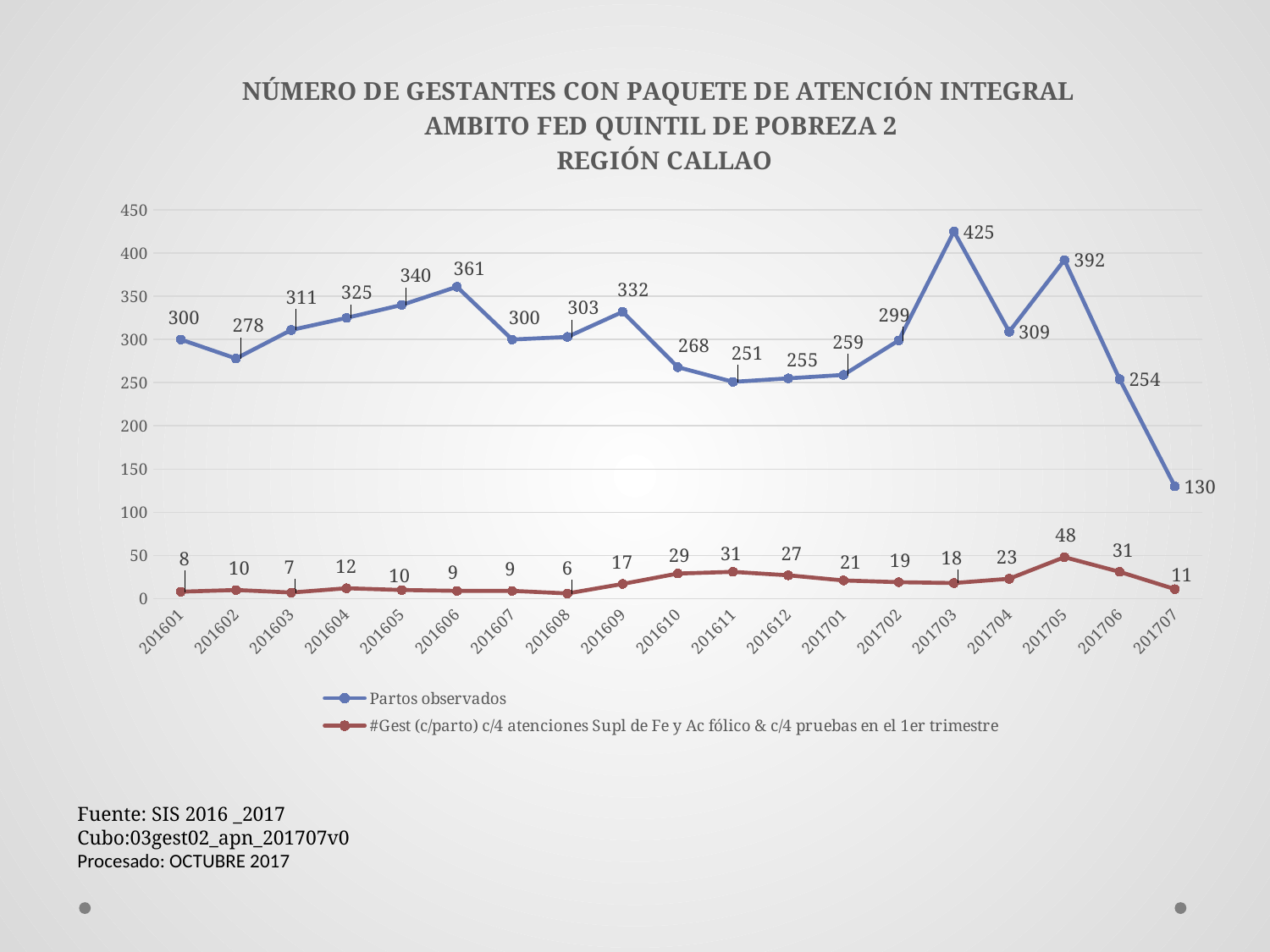
Does the Partos observados series rise or fall from 201705 to 201707? Fall What is the value of Partos observados for 201707? 130 What kind of chart is shown on the slide? Line chart Which period has the lowest value for the #Gest (c/parto) series? 201608 What is the value of the #Gest (c/parto) series for 201705? 48 Is the value of Partos observados for 201705 greater or less than 350? greater What is the value of Partos observados for 201703? 425 Which period has the highest value for Partos observados? 201703 How many periods are shown on the x axis? 19 How many series does the legend list? 2 Which is larger, Partos observados in 201606 or in 201609? 201606 What is the difference between Partos observados in 201703 and 201704? 116